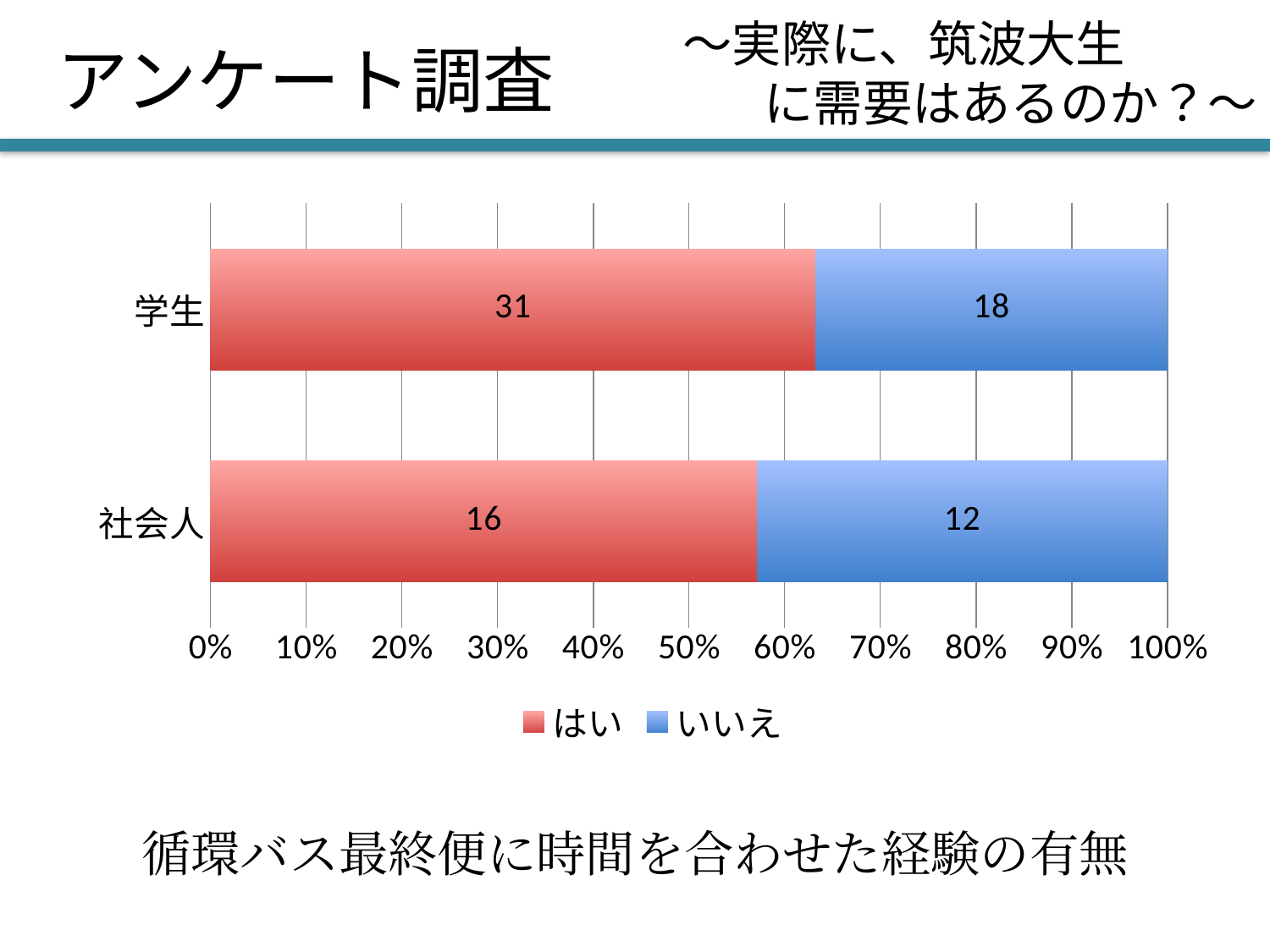
What is the total of the two values in the 学生 bar? 49 What is the difference between the はい values for 学生 and 社会人? 15 Which is larger for 社会人: はい or いいえ? はい How many series does the legend list? 2 What kind of chart is shown on the slide? Stacked bar chart What is the total of the two values in the 社会人 bar? 28 What is the value for はい in the 学生 category? 31 What is the value for いいえ in the 学生 category? 18 What is the value for いいえ in the 社会人 category? 12 Which category has the higher はい value? 学生 How many categories are shown on the chart? 2 What is the value for はい in the 社会人 category? 16